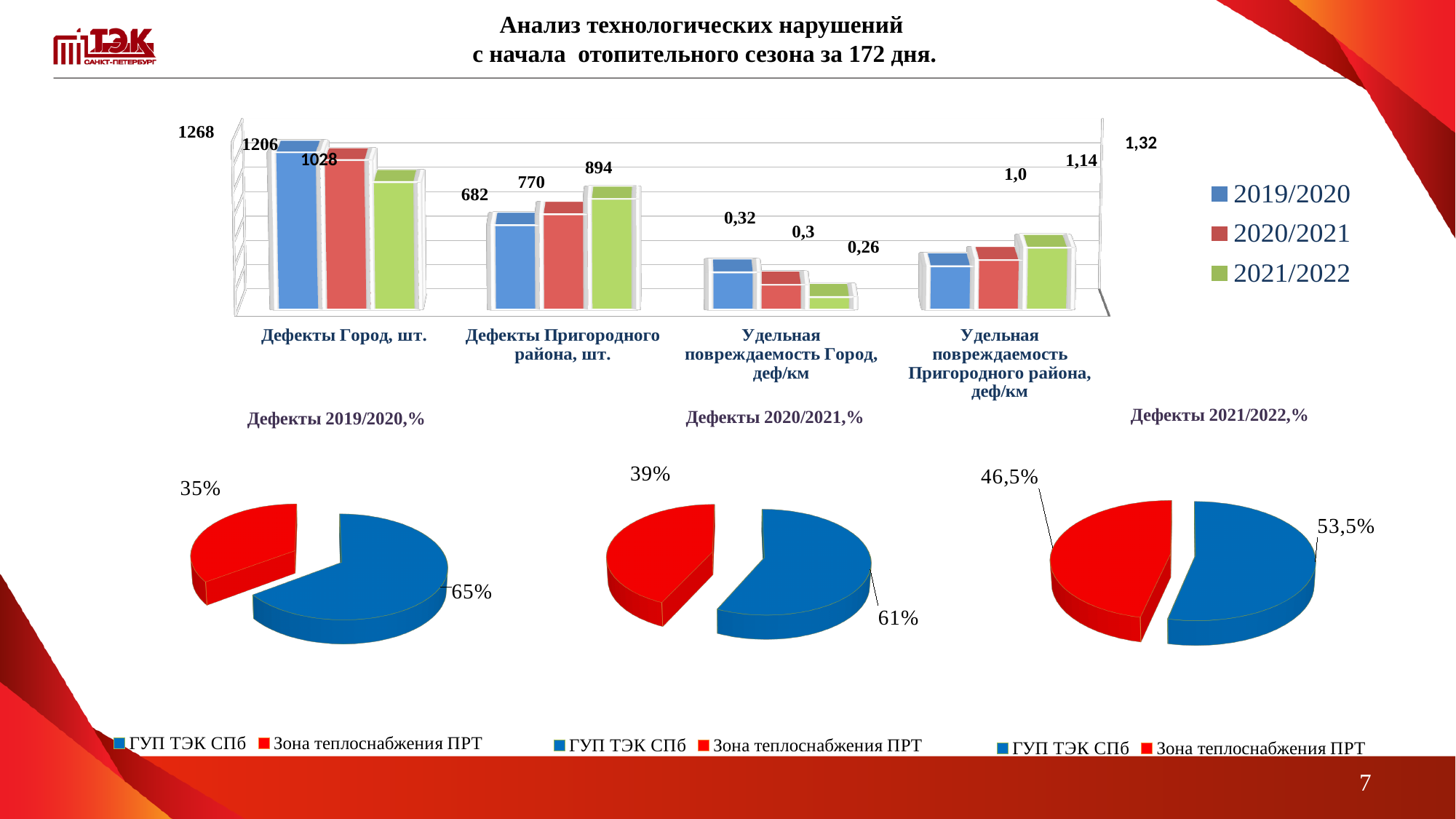
In the top bar chart, what is the difference between the 2019/2020 and 2021/2022 values for 'Дефекты Город, шт.'? 240 In the top bar chart, what is the value for 2021/2022 in the category 'Удельная повреждаемость Пригородного района, деф/км'? 1,32 In the top bar chart, which season has the lowest value in the category 'Дефекты Пригородного района, шт.'? 2019/2020 In the top bar chart, which season has the highest value in the category 'Дефекты Город, шт.'? 2019/2020 In the pie chart 'Дефекты 2021/2022,%', what share does 'ГУП ТЭК СПб' have? 53,5% How many series does the legend of the top bar chart list? 3 In the top bar chart, what is the value for 2021/2022 in the category 'Дефекты Пригородного района, шт.'? 894 In the top bar chart, what is the value for 2019/2020 in the category 'Удельная повреждаемость Город, деф/км'? 0,32 In the pie chart 'Дефекты 2019/2020,%', what share does 'Зона теплоснабжения ПРТ' have? 35% In the top bar chart, do the values for 'Удельная повреждаемость Город, деф/км' rise or fall from 2019/2020 to 2021/2022? fall In the pie chart 'Дефекты 2020/2021,%', which is larger: the share of 'ГУП ТЭК СПб' or 'Зона теплоснабжения ПРТ'? ГУП ТЭК СПб How many categories are shown on the x axis of the top bar chart? 4